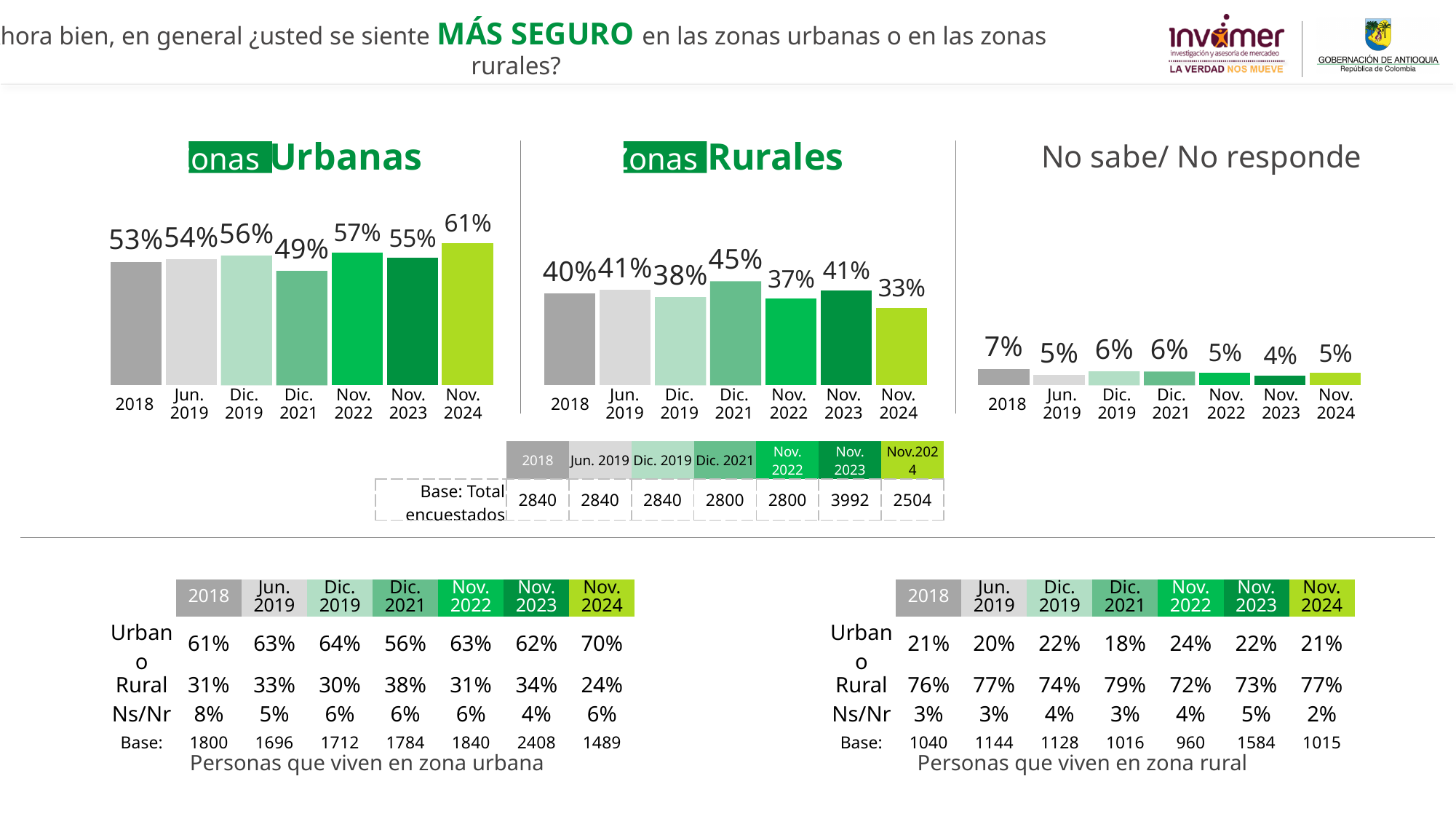
In the No sabe/ No responde chart, which period has the lowest value? Nov. 2023 How many bars are in the No sabe/ No responde chart? 7 In the Zonas Urbanas chart, what is the value for Nov. 2024? 61% In the Zonas Urbanas chart, what is the difference between the Nov. 2024 value and the Dic. 2021 value? 12% In the Zonas Rurales chart, which period has the highest value? Dic. 2021 What kind of chart is the Zonas Urbanas chart? bar chart In the Zonas Rurales chart, which period has the lowest value? Nov. 2024 In the Zonas Rurales chart, what is the value for Dic. 2021? 45% In the Zonas Rurales chart, which is larger: the value for 2018 or the value for Nov. 2022? 2018 In the No sabe/ No responde chart, what is the value for 2018? 7% In the Zonas Rurales chart, what is the difference between the Dic. 2021 value and the Nov. 2024 value? 12% In the Zonas Urbanas chart, which period has the lowest value? Dic. 2021